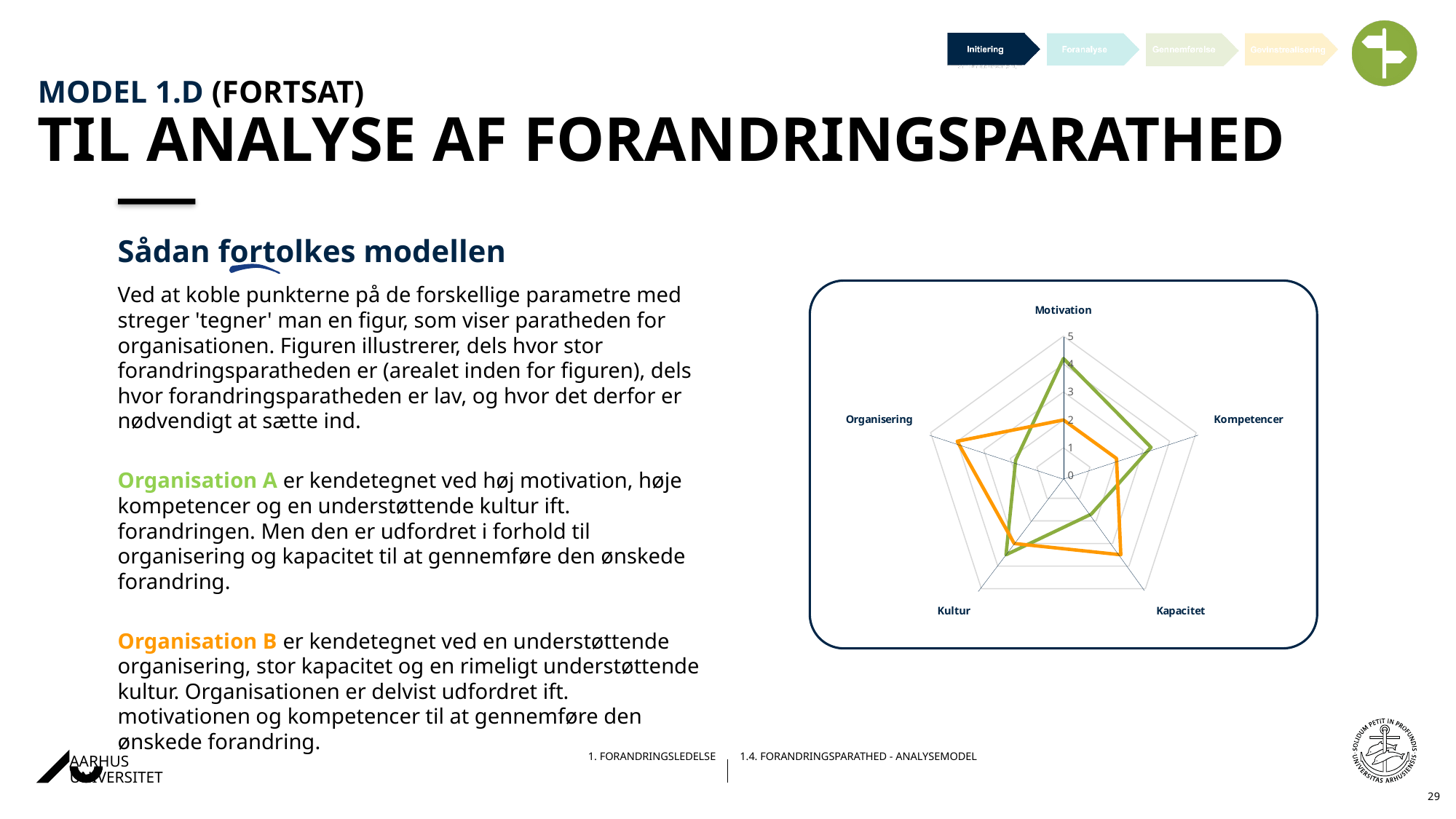
Is the Kapacitet value for Organisation A (green line) greater or less than 2? less What is the Motivation value for Organisation B (orange line)? 2 Which organisation has the higher Kapacitet value, A (green) or B (orange)? Organisation B What is the maximum value shown on the radar chart's scale? 5 Is the Organisering value for Organisation B (orange line) greater or less than 3? greater What kind of chart is shown on the slide? radar chart How many organisations are plotted on the radar chart? 2 On which parameter does Organisation B (orange line) score lowest? Motivation and Kompetencer (tied at 2) How many parameters (axes) does the radar chart have? 5 Which organisation has the higher Kompetencer value, A (green) or B (orange)? Organisation A